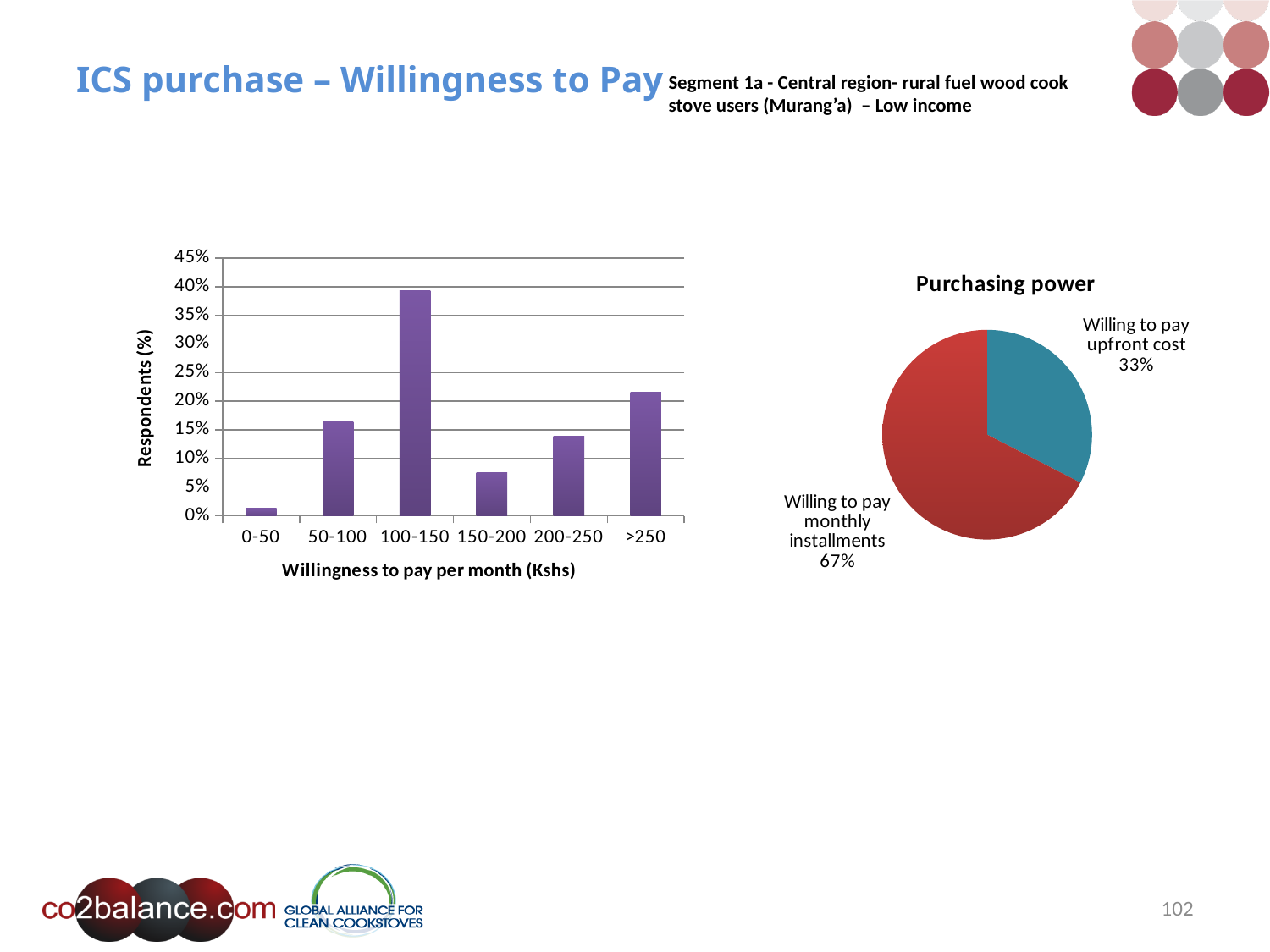
In the bar chart on the left, is the value for 100-150 greater or less than 35%? greater In the bar chart on the left, which willingness-to-pay range has the highest share of respondents? 100-150 What type of chart is the chart on the left of the slide? bar chart In the bar chart on the left, which willingness-to-pay range has the lowest share of respondents? 0-50 In the Purchasing power pie chart, what share of respondents are willing to pay upfront cost? 33% In the bar chart on the left, which is larger, the value for 50-100 or the value for 200-250? 50-100 In the Purchasing power pie chart, what is the difference between the monthly installments share and the upfront cost share? 34% In the bar chart on the left, is the value for >250 greater or less than 20%? greater What is the x-axis title of the bar chart on the left? Willingness to pay per month (Kshs) In the Purchasing power pie chart, what share of respondents are willing to pay monthly installments? 67% How many willingness-to-pay categories are shown in the bar chart on the left? 6 In the bar chart on the left, is the value for 150-200 greater or less than 10%? less